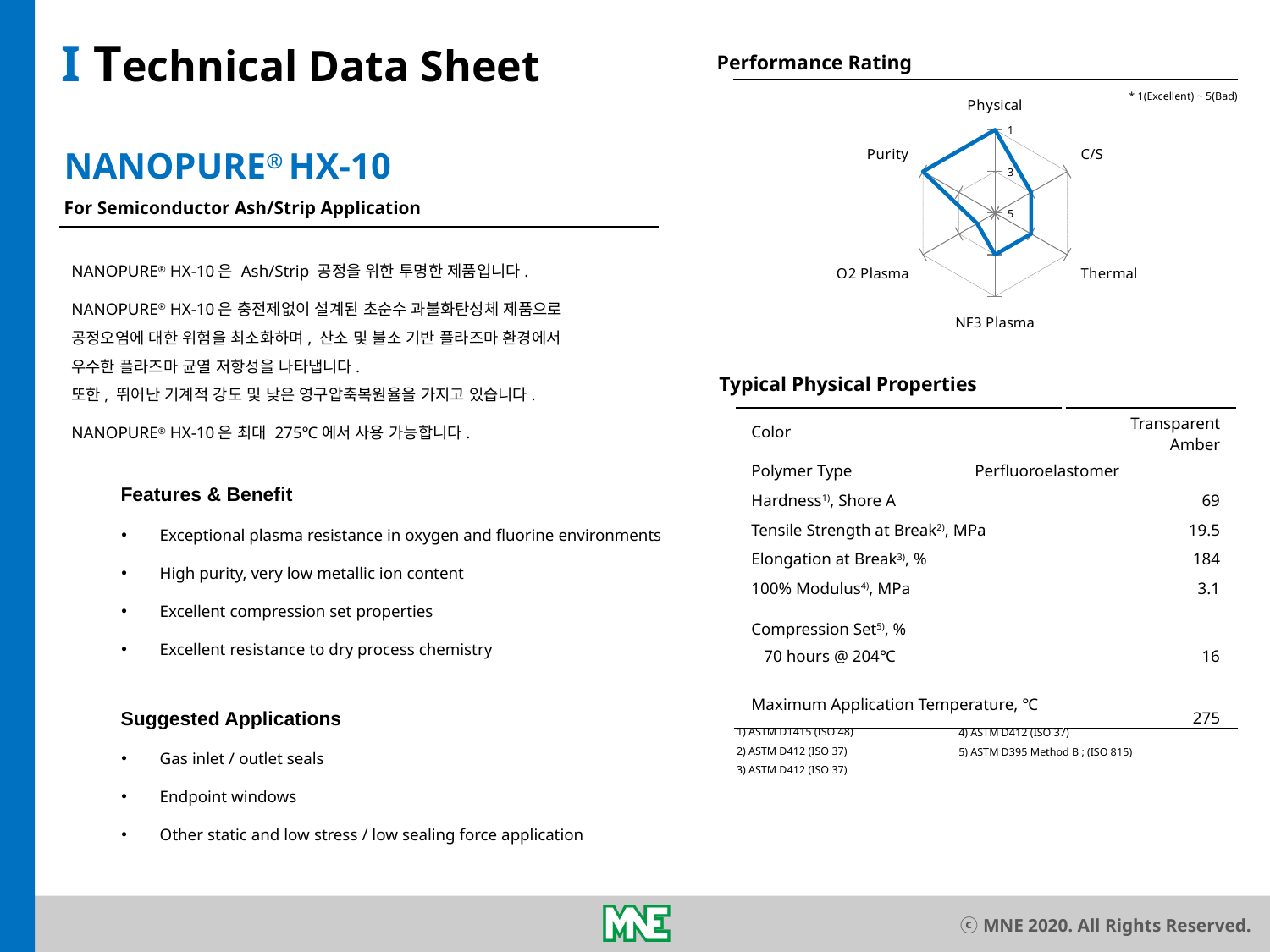
In the Performance Rating chart, is the rating for Physical greater or less than 3? less What is the title of the chart on the slide? Performance Rating Which category is plotted at the top of the Performance Rating radar chart? Physical What kind of chart is shown under "Performance Rating"? Radar chart According to the note on the Performance Rating chart, what rating value means Excellent? 1 How many performance categories (axes) does the Performance Rating radar chart have? 6 In the Performance Rating chart, is the rating for Purity greater or less than 3? less